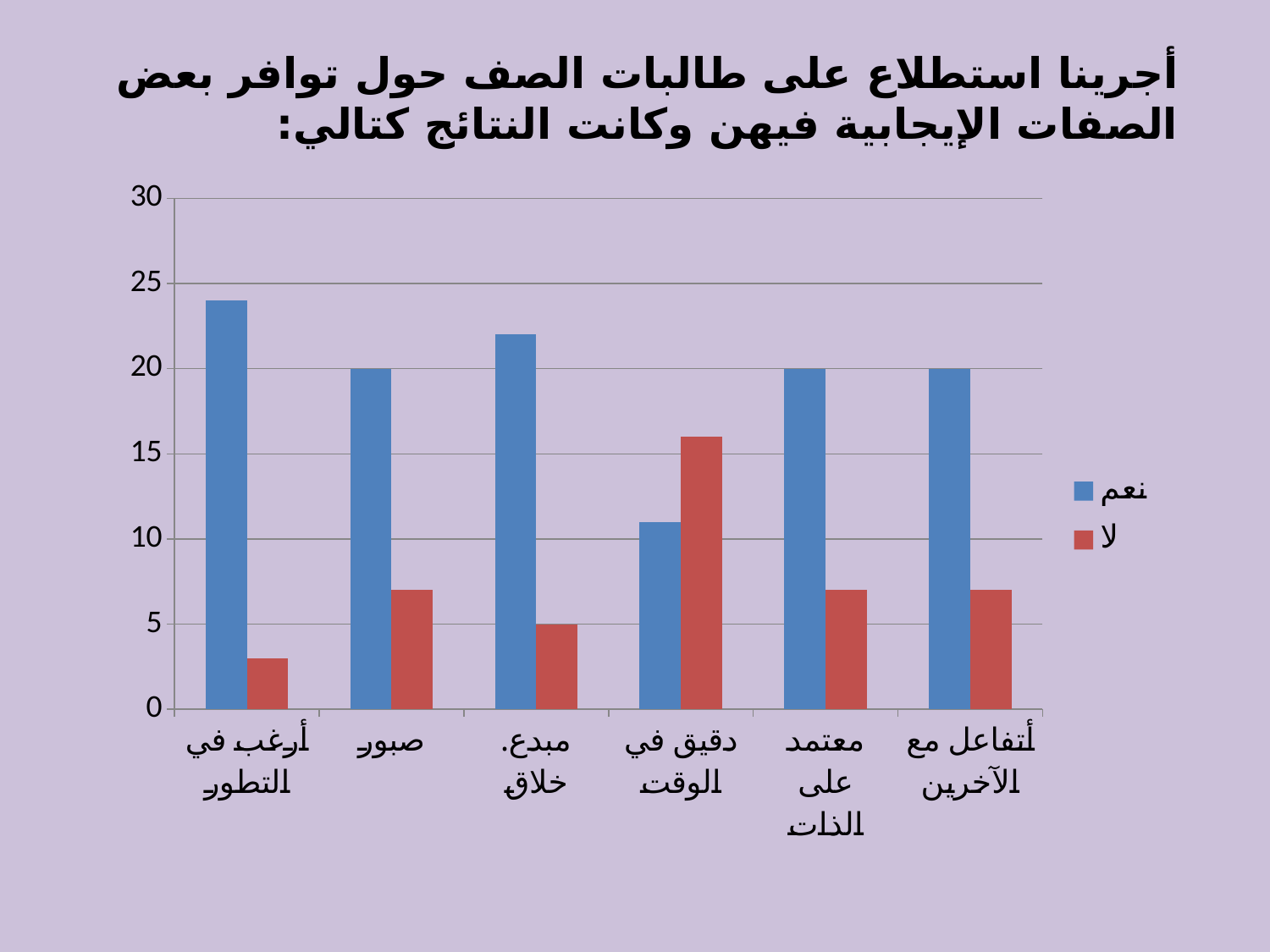
What kind of chart is shown on the slide? bar chart What is the value of نعم for صبور? 20 Is the value of نعم for أرغب في التطور greater or less than 20? greater What is the value of لا for مبدع. خلاق? 5 How many series does the legend list? 2 Which category has the lowest value for نعم? دقيق في الوقت Which category has the highest value for نعم? أرغب في التطور Which category has the highest value for لا? دقيق في الوقت Which legend entry is shown in red? لا What is the value of نعم for أتفاعل مع الآخرين? 20 For دقيق في الوقت, which is larger: نعم or لا? لا How many categories are shown on the x axis? 6